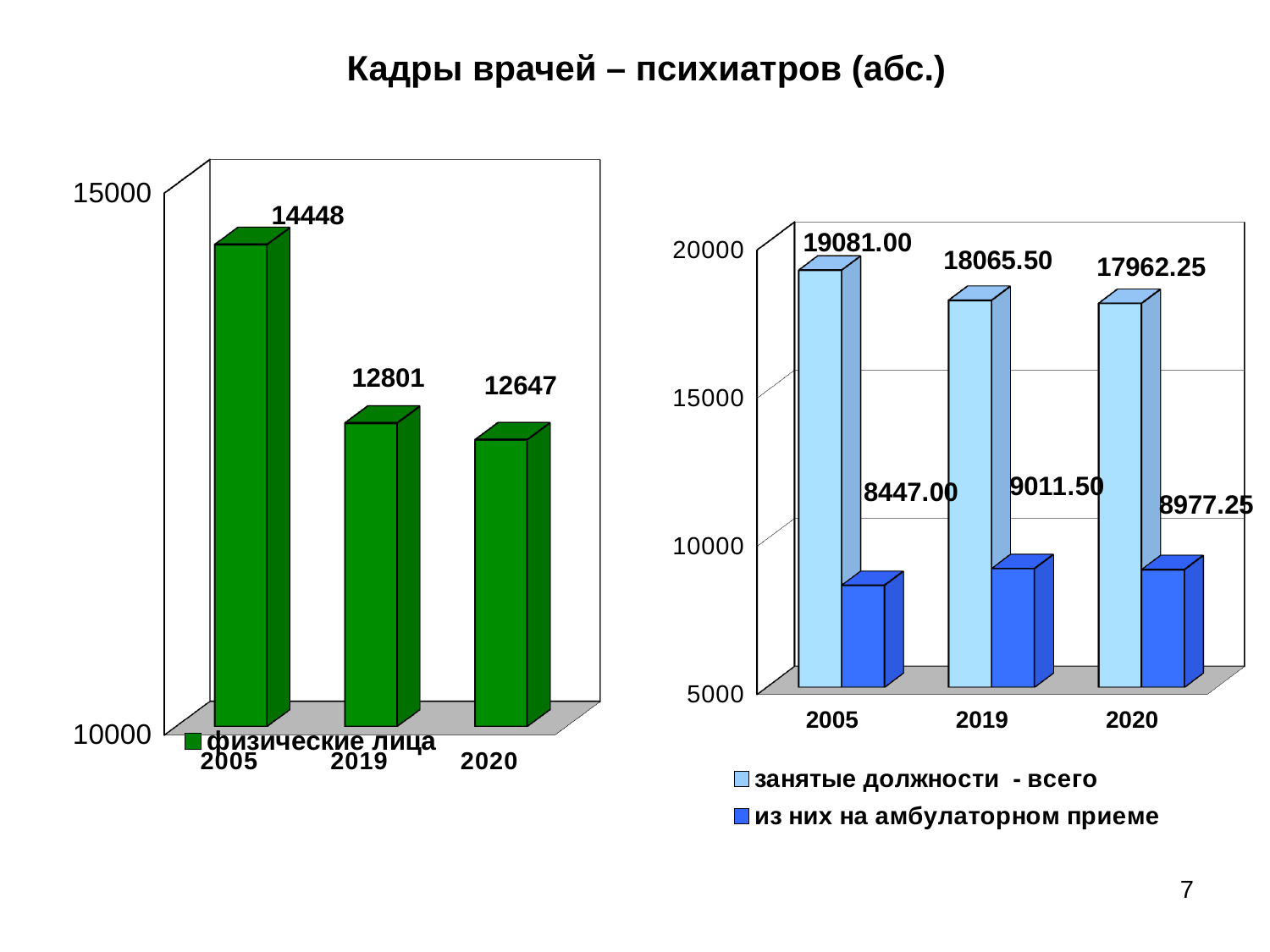
In the right chart, which year has the lowest value for занятые должности - всего? 2020 In the left chart, what is the value for физические лица in 2005? 14448 In the left chart, what is the value for физические лица in 2020? 12647 In the right chart, which year has the highest value for из них на амбулаторном приеме? 2019 In the left chart, what is the difference between the 2005 and 2019 values? 1647 What type of chart is the left chart? bar chart In the left chart, which year has the highest value? 2005 How many series does the legend of the right chart list? 2 In the right chart, what is the value for занятые должности - всего in 2019? 18065.50 In the right chart, what is the difference between занятые должности - всего and из них на амбулаторном приеме in 2020? 8985.00 In the right chart, what is the value for из них на амбулаторном приеме in 2005? 8447.00 In the left chart, do the values rise or fall from 2005 to 2020? fall